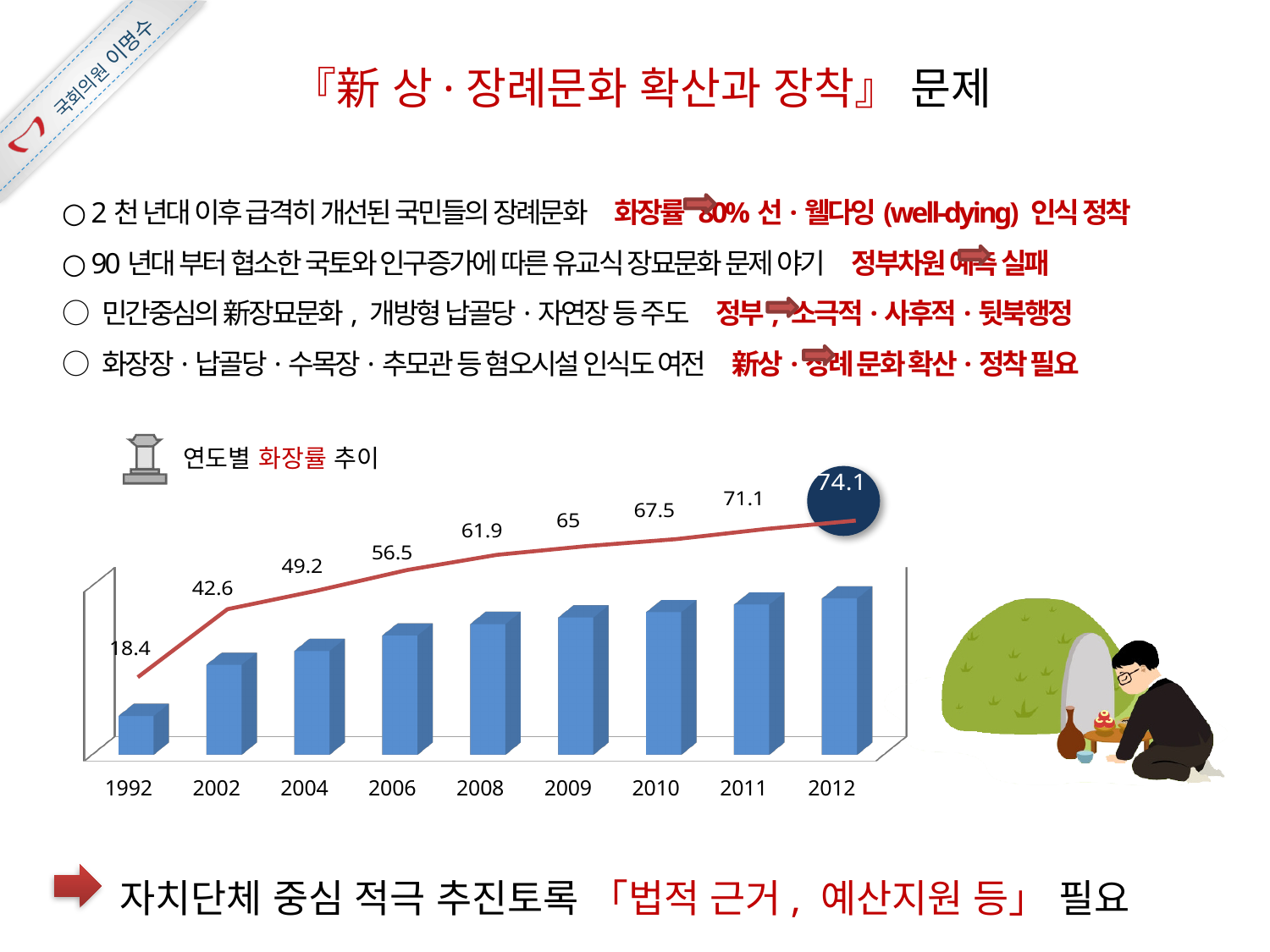
Which is larger in the 연도별 화장률 추이 chart, the value for 2006 or the value for 2010? 2010 What is the difference between the values for 2002 and 1992 in the 연도별 화장률 추이 chart? 24.2 What is the cremation rate shown for 1992 in the 연도별 화장률 추이 chart? 18.4 What value is shown for 2004 in the 연도별 화장률 추이 chart? 49.2 What value is shown for 2008 in the 연도별 화장률 추이 chart? 61.9 Which year has the lowest value in the 연도별 화장률 추이 chart? 1992 What kind of chart is the 연도별 화장률 추이 chart? Bar chart with a line overlay What value is shown for 2012 in the 연도별 화장률 추이 chart? 74.1 How many years are shown on the x axis of the 연도별 화장률 추이 chart? 9 Which year has the highest value in the 연도별 화장률 추이 chart? 2012 Do the values in the 연도별 화장률 추이 chart rise or fall from 1992 to 2012? Rise What is the difference between the values for 2012 and 1992 in the 연도별 화장률 추이 chart? 55.7